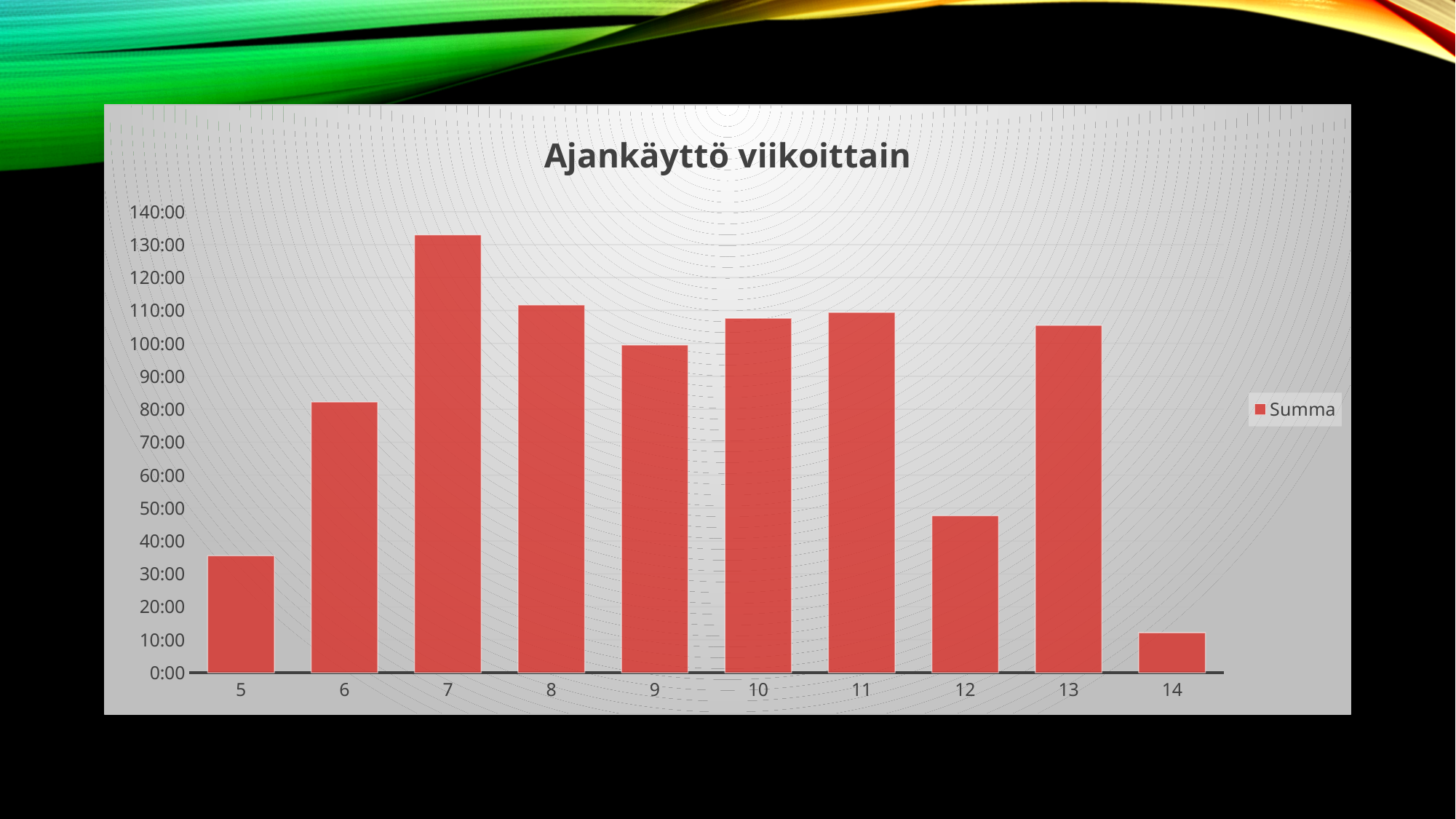
How many categories are plotted on the x axis? 10 Which has the larger value, category 6 or category 12? 6 Is the value for category 12 greater or less than 50:00? less Do the values rise or fall from category 7 to category 9? fall What is the title of the chart? Ajankäyttö viikoittain Which category has the lowest value? 14 How many series does the legend list? 1 Which has the larger value, category 8 or category 9? 8 Which category has the highest value? 7 What kind of chart is shown on the slide? bar chart What is the name of the series shown in the legend? Summa Is the value for category 7 greater or less than 120:00? greater